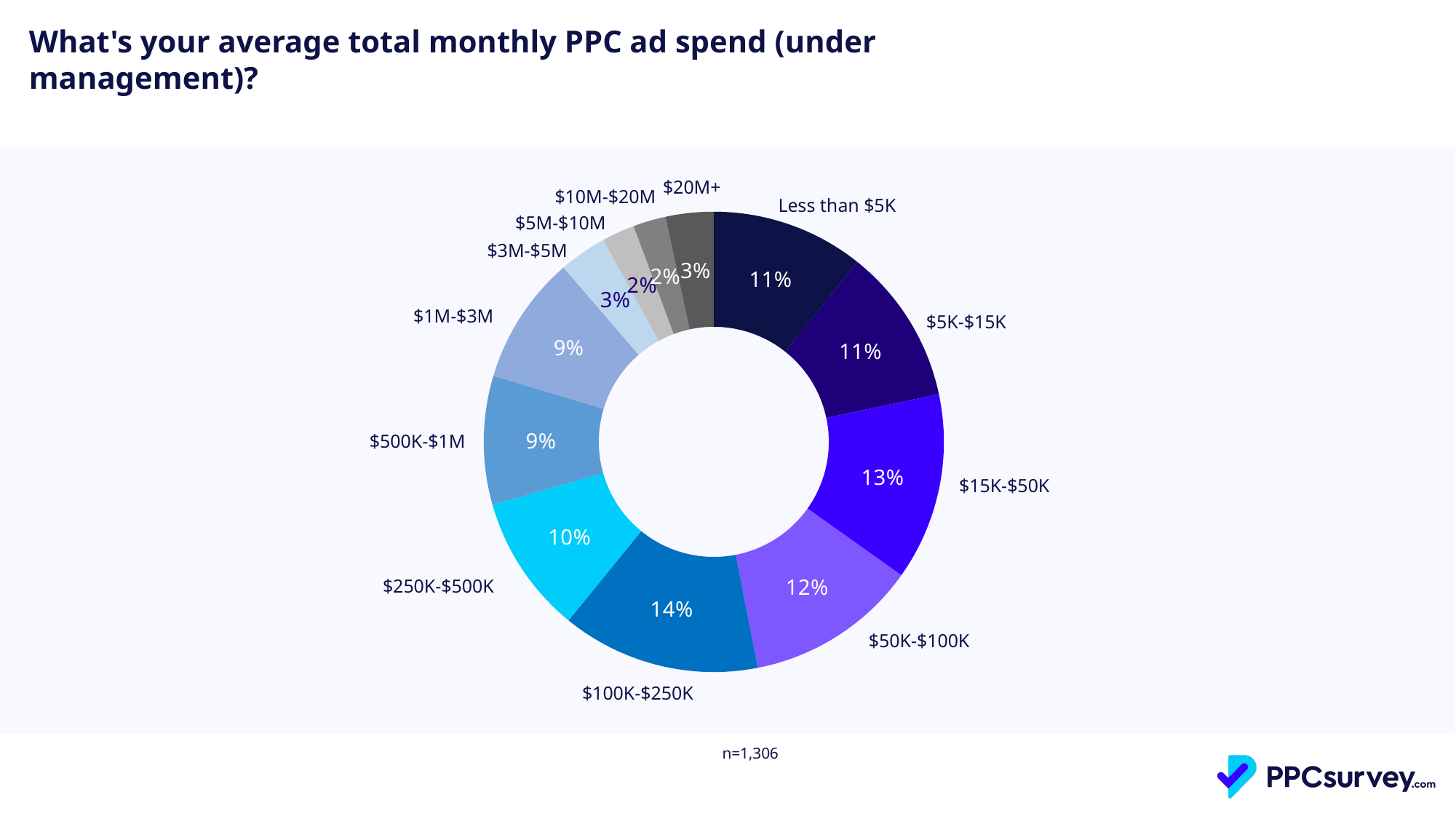
What is the value for the $500K-$1M category? 9% Which spend category has the largest share of respondents? $100K-$250K What share of respondents reported spending less than $5K per month? 11% What is the title of the chart? What's your average total monthly PPC ad spend (under management)? What kind of chart is shown on the slide? Pie chart (donut) What percentage of respondents have an average monthly PPC ad spend of $100K-$250K? 14% What is the sample size (n) shown below the chart? n=1,306 What is the difference in percentage points between the $100K-$250K slice and the $250K-$500K slice? 4 percentage points What is the value for the $250K-$500K category? 10% What percentage is shown for the $20M+ slice? 3% How many spend categories are shown in the chart? 12 Which is larger: the share for $15K-$50K or the share for $50K-$100K? $15K-$50K